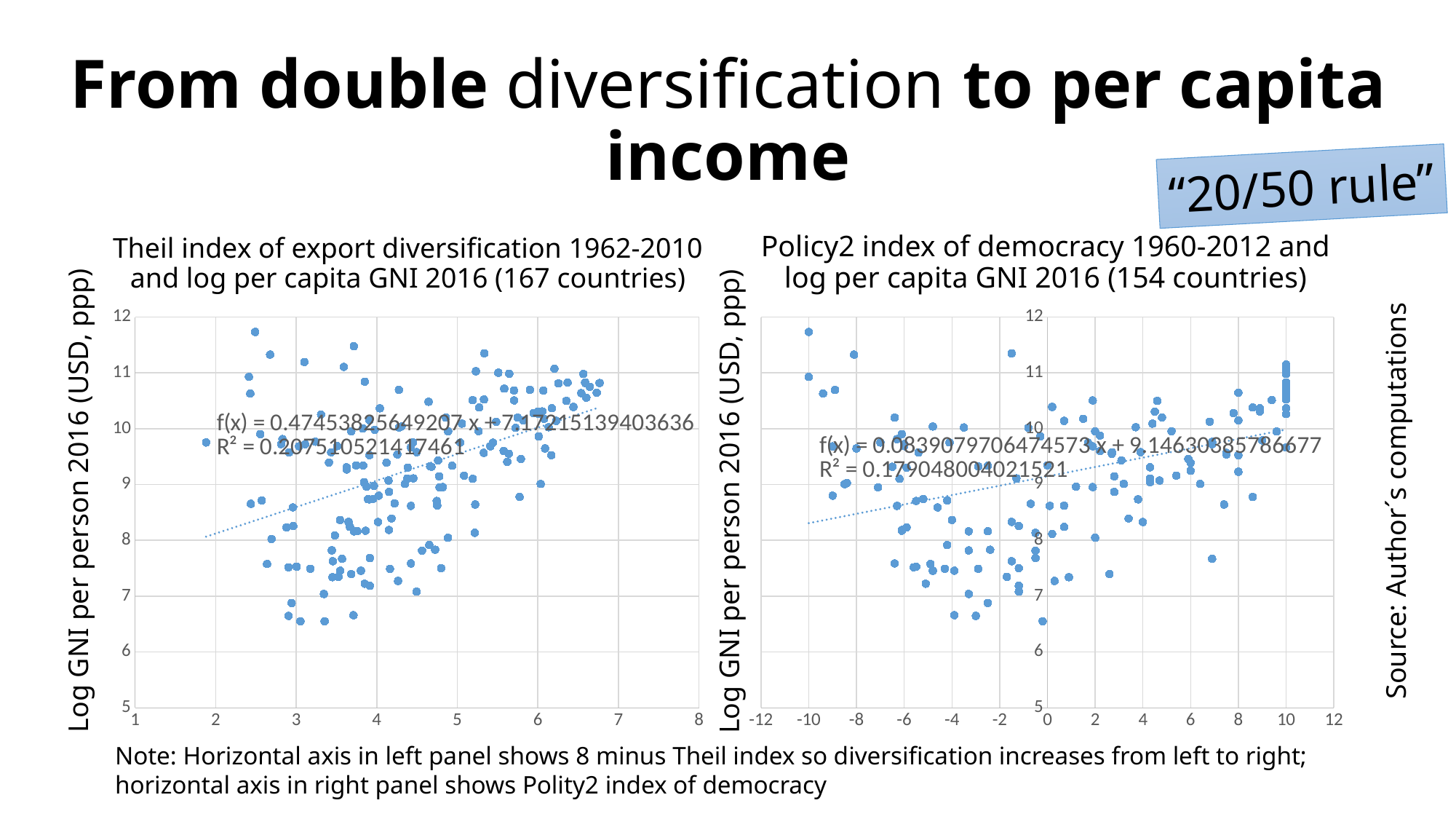
How many charts are shown on the slide? 2 According to its title, how many countries are plotted in the right chart (Policy2 index of democracy)? 154 countries In the left chart (Theil index of export diversification), does the fitted trend line rise or fall from left to right? Rises What is the R² value shown on the left chart (Theil index of export diversification)? 0.207510521417461 In the right chart (Policy2 index of democracy), does the fitted trend line rise or fall from left to right? Rises What kind of chart is the right chart, titled "Policy2 index of democracy 1960-2012 and log per capita GNI 2016"? Scatter chart What is the highest tick value on the vertical axis of the left chart (Theil index of export diversification)? 12 What is the lowest tick value on the horizontal axis of the right chart (Policy2 index of democracy)? -12 According to its title, how many countries are plotted in the left chart (Theil index of export diversification)? 167 countries What is the R² value shown on the right chart (Policy2 index of democracy)? 0.179048004021521 Which chart has the higher R² value, the left chart (Theil index) or the right chart (Policy2 index)? The left chart (Theil index) What kind of chart is the left chart, titled "Theil index of export diversification 1962-2010 and log per capita GNI 2016"? Scatter chart